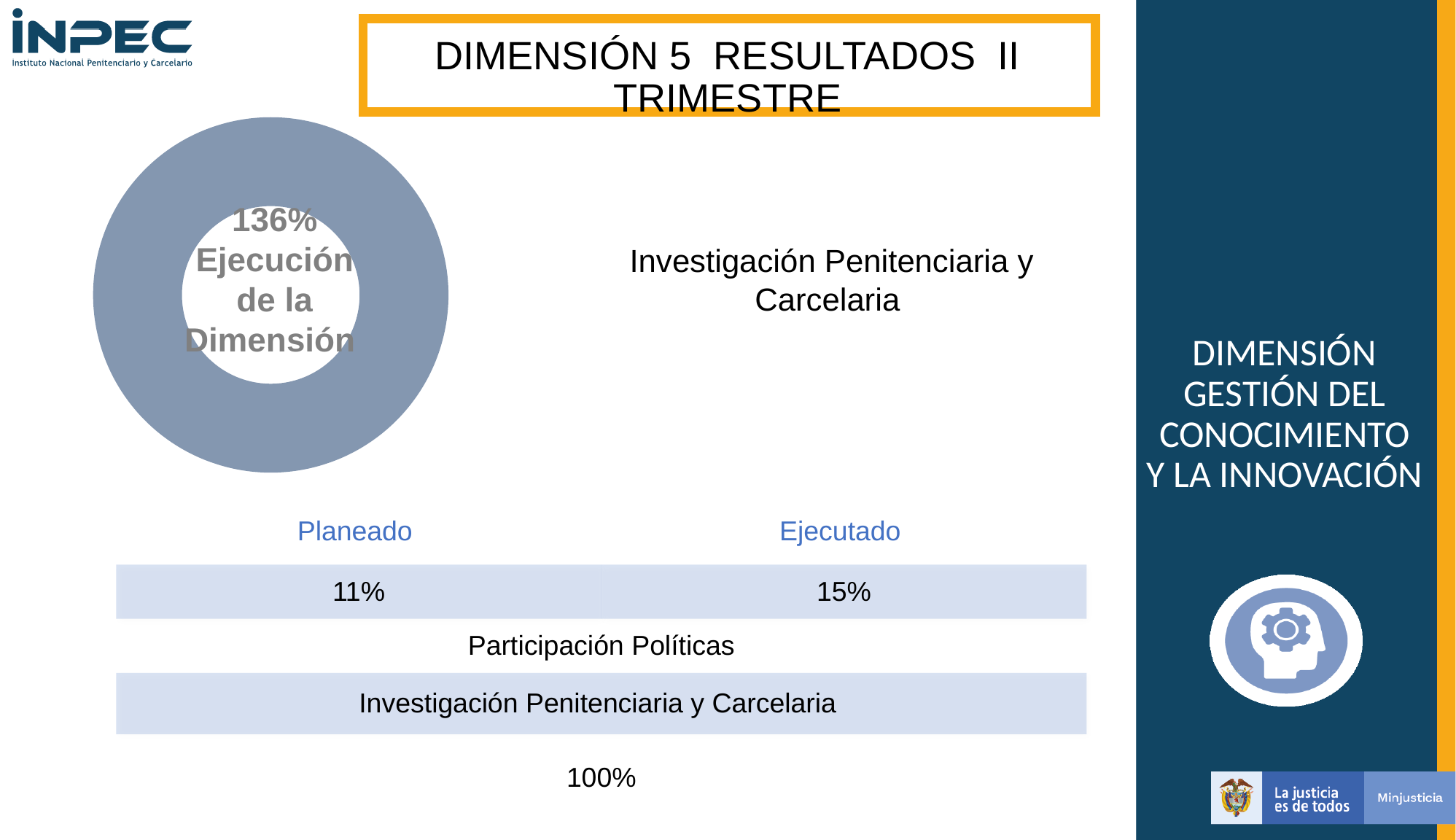
What kind of chart is shown on the left of the slide? doughnut chart In the table below the chart, what is the Ejecutado value? 15% How many distinct slices are visible in the doughnut chart? 1 In the table below the chart, what is the difference between Ejecutado and Planeado? 4% In the table below the chart, which is larger, Planeado or Ejecutado? Ejecutado What colour is the ring of the doughnut chart? grey-blue In the table below the chart, what is the Planeado value? 11% Is the execution value shown in the doughnut chart greater or less than 100%? greater What does the text in the centre of the doughnut chart say the 136% represents? Ejecución de la Dimensión What percentage is printed in the centre of the doughnut chart? 136% What value is printed at the bottom of the table for Investigación Penitenciaria y Carcelaria? 100%